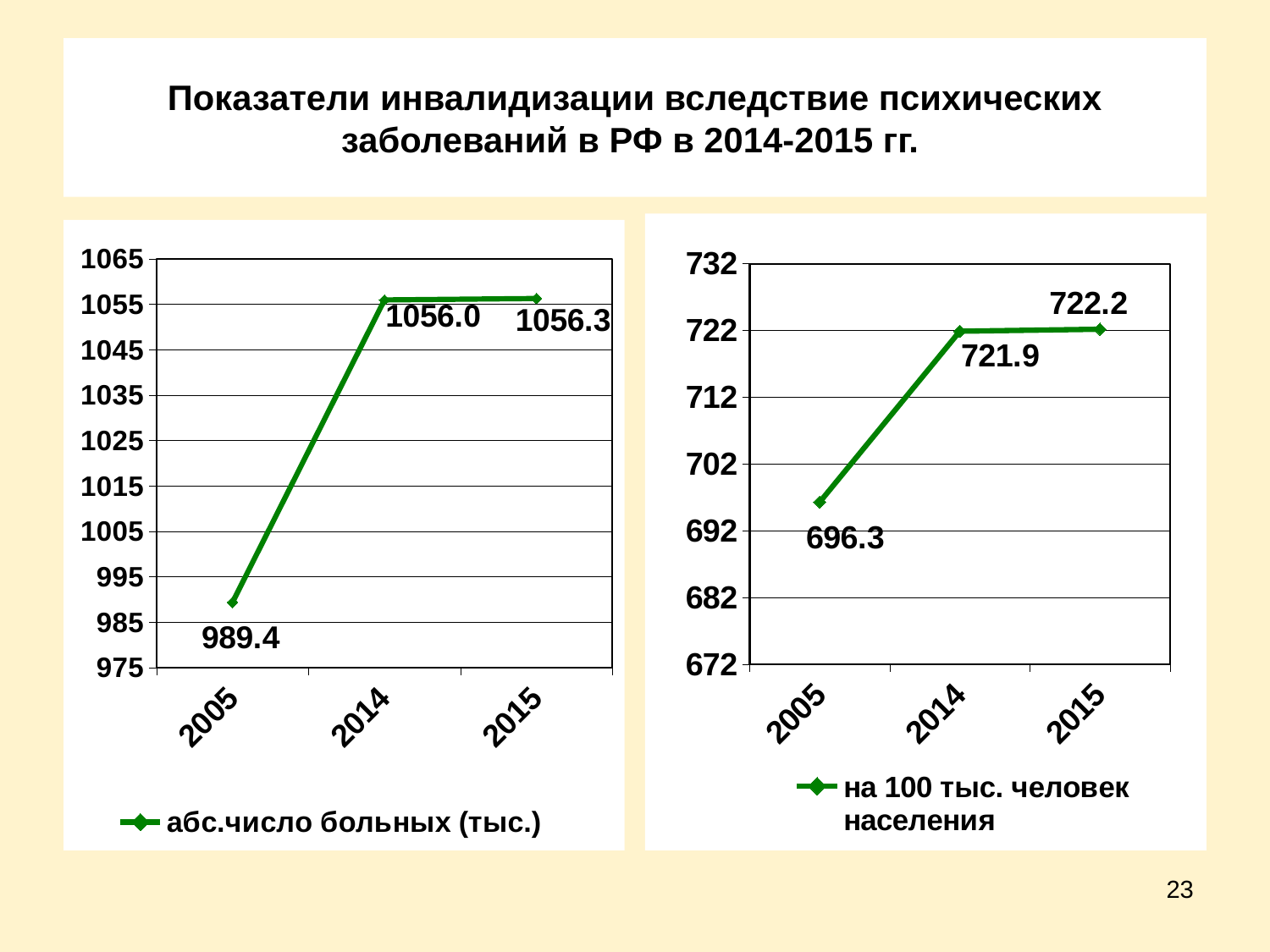
In the left chart, do the values rise or fall from 2005 to 2015? rise In the right chart (на 100 тыс. человек населения), what is the value for 2005? 696.3 How many data points are plotted in the left chart? 3 In the left chart (абс.число больных (тыс.)), what is the value for 2005? 989.4 In the left chart, what is the difference between the values for 2014 and 2005? 66.6 What type of chart is the right chart? line chart In the left chart (абс.число больных (тыс.)), what is the value for 2015? 1056.3 In the right chart, is the value for 2005 larger or smaller than the value for 2014? smaller In the left chart, which year has the lowest value? 2005 In the right chart, what is the difference between the values for 2015 and 2005? 25.9 In the right chart, which year has the highest value? 2015 In the right chart (на 100 тыс. человек населения), what is the value for 2014? 721.9